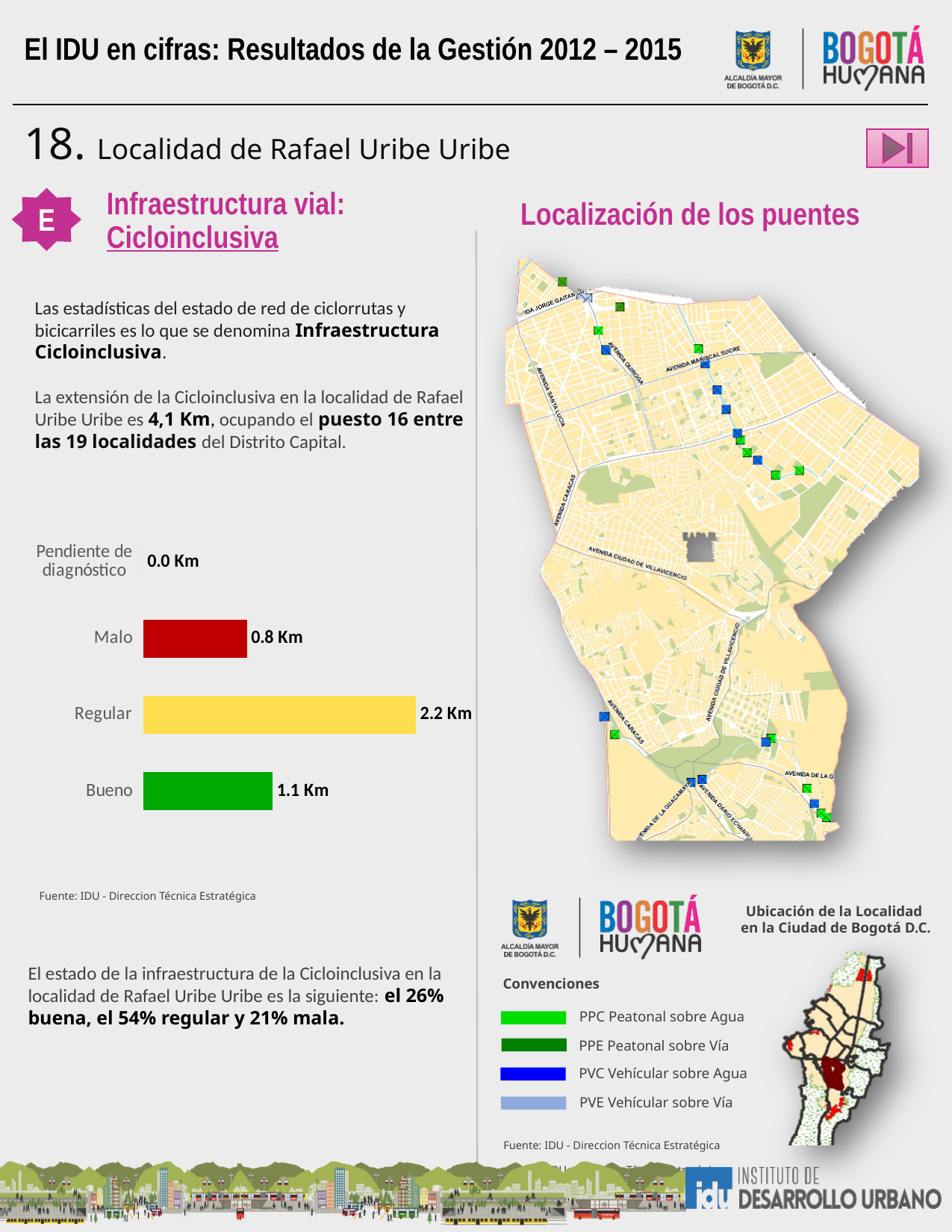
What is the value for Regular in the bar chart? 2.2 Km What is the value for Malo in the bar chart? 0.8 Km What kind of chart is shown on the left of the slide? Bar chart How many categories does the bar chart show? 4 Which category has the highest value in the bar chart? Regular What is the difference between the values for Bueno and Malo in the bar chart? 0.3 Km Which category has the lowest value in the bar chart? Pendiente de diagnóstico Which is larger in the bar chart, the value for Bueno or the value for Malo? Bueno What colour is the bar for Regular in the bar chart? Yellow What is the value for Bueno in the bar chart? 1.1 Km What is the difference between the values for Regular and Bueno in the bar chart? 1.1 Km What is the value for Pendiente de diagnóstico in the bar chart? 0.0 Km